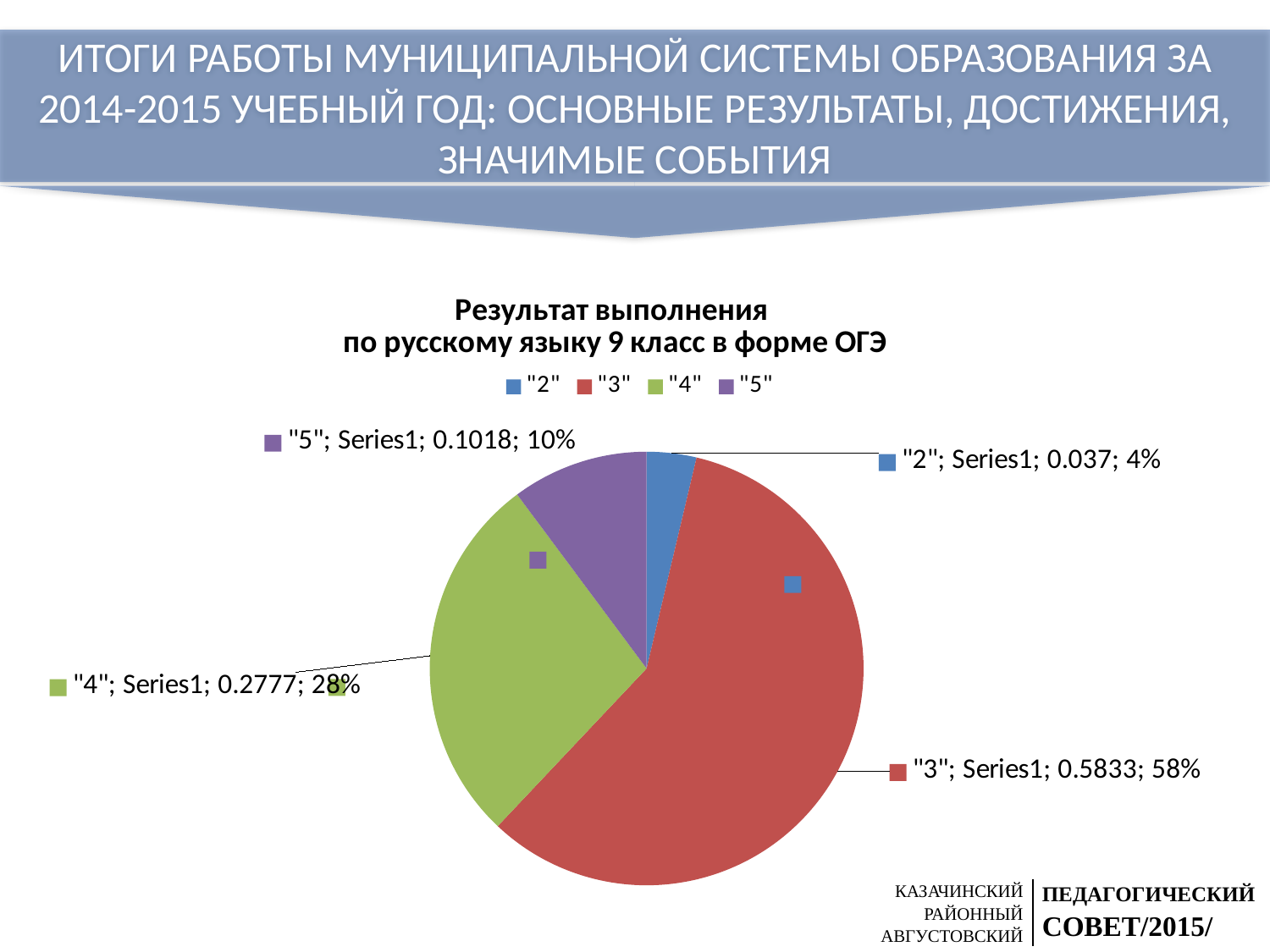
Which grade has the smallest slice of the pie? "2" How many entries does the legend list? 4 What percentage share does the "4" slice have? 28% What percentage share does the "2" slice have? 4% What value is printed for the "3" slice? 0.5833 What kind of chart is shown on the slide? pie chart What percentage share does the "5" slice have? 10% How many slices does the pie chart have? 4 Which grade has the largest slice of the pie? "3" What value is printed for the "2" slice? 0.037 What is the title of the chart? Результат выполнения по русскому языку 9 класс в форме ОГЭ